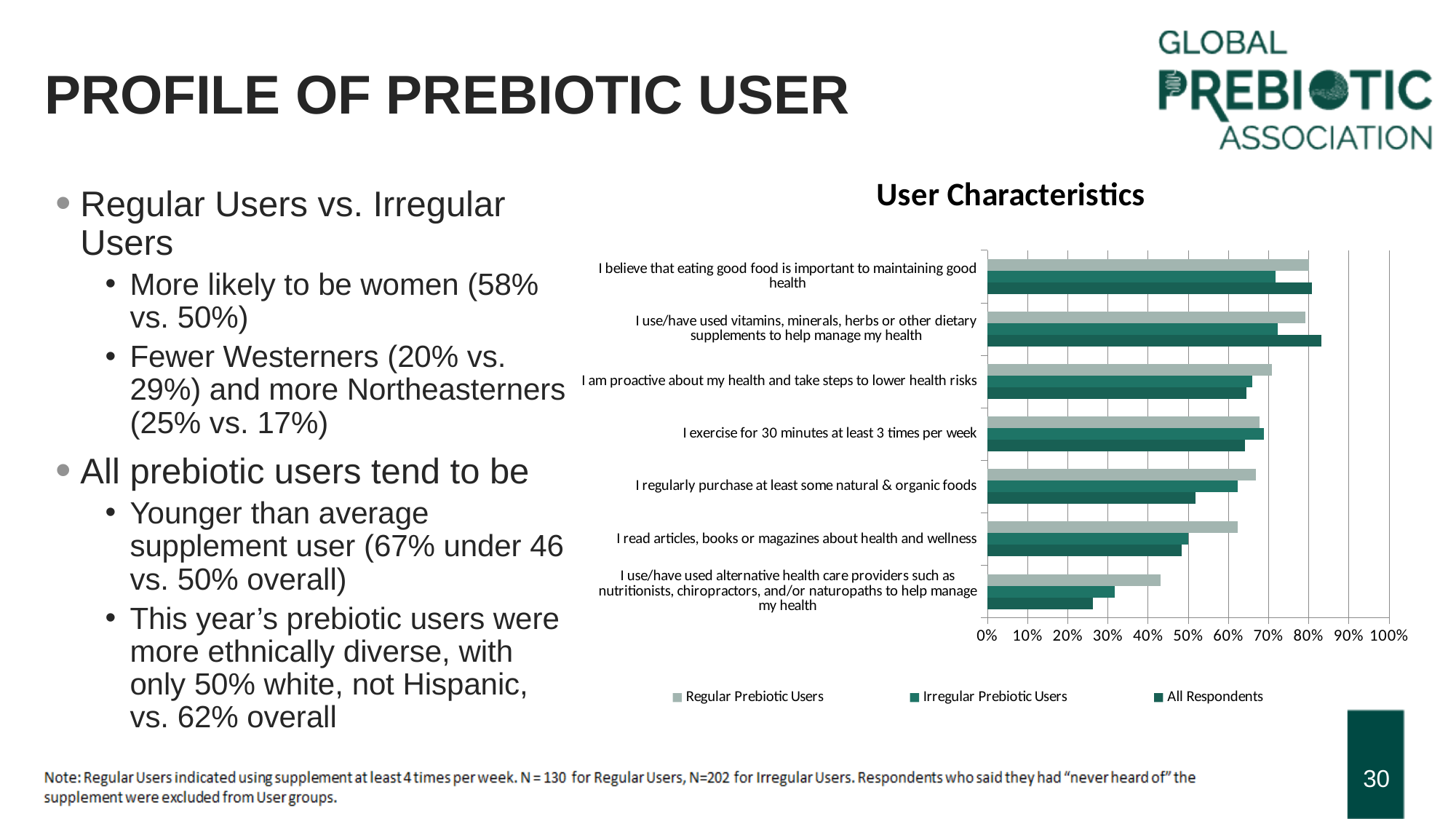
Is the Regular Prebiotic Users value for "I believe that eating good food is important to maintaining good health" greater or less than 70%? greater What is the title of the chart on the slide? User Characteristics How many series does the legend of the "User Characteristics" chart list? 3 Is the Regular Prebiotic Users value for "I use/have used alternative health care providers..." greater or less than 50%? less Which statement has the lowest value for Regular Prebiotic Users? I use/have used alternative health care providers such as nutritionists, chiropractors, and/or naturopaths to help manage my health What are the three series listed in the chart legend? Regular Prebiotic Users, Irregular Prebiotic Users, All Respondents For "I regularly purchase at least some natural & organic foods", which is larger: Irregular Prebiotic Users or All Respondents? Irregular Prebiotic Users Is the Irregular Prebiotic Users value for "I use/have used alternative health care providers..." greater or less than 40%? less What kind of chart is the "User Characteristics" chart? Bar chart For "I read articles, books or magazines about health and wellness", which is larger: Regular Prebiotic Users or Irregular Prebiotic Users? Regular Prebiotic Users How many user characteristic statements are plotted on the chart? 7